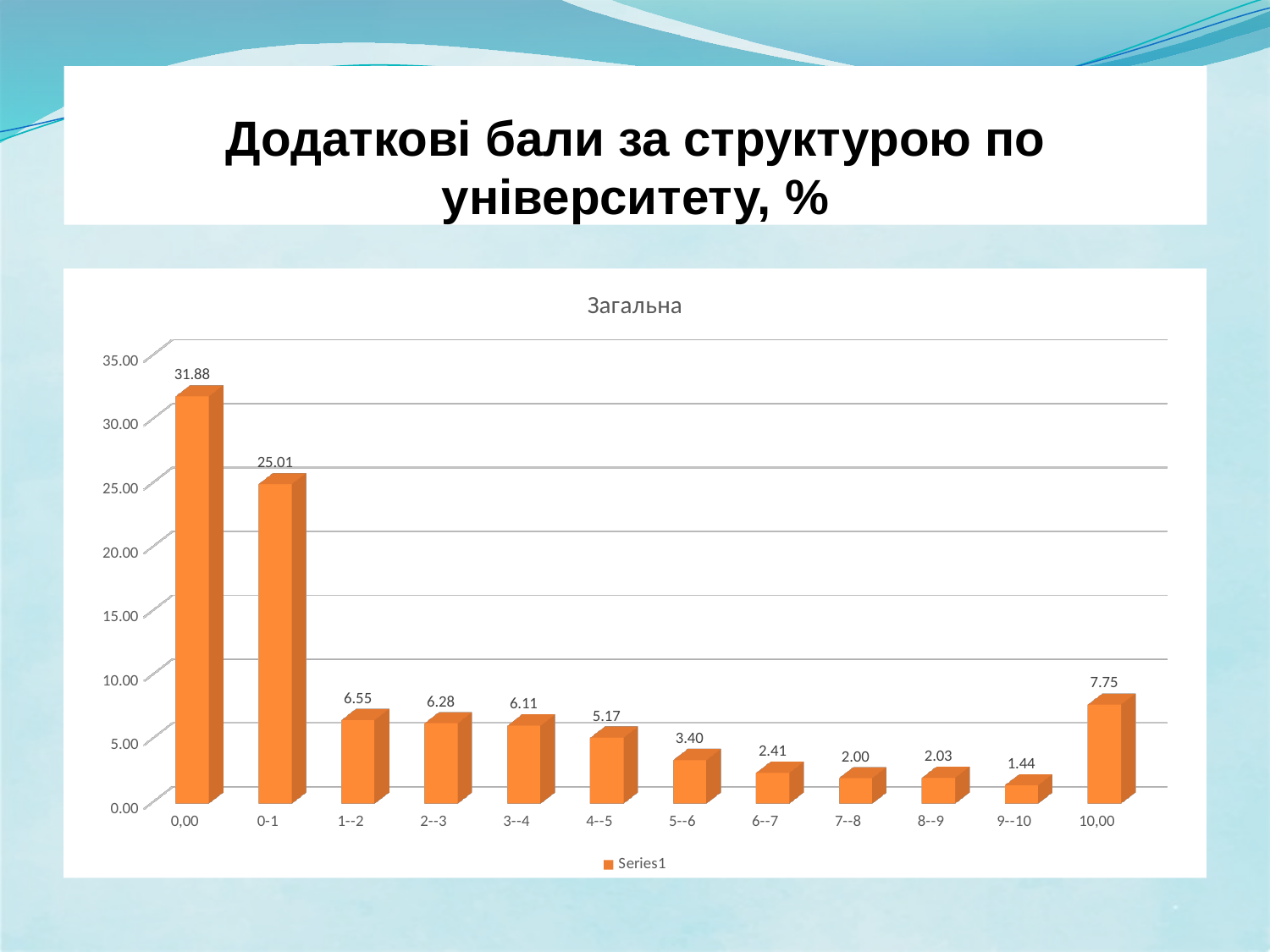
How many categories are shown on the x axis? 12 Which category has the highest value? 0,00 Which is larger, the value for 1--2 or the value for 10,00? 10,00 What is the value for the category 5--6? 3.40 What is the value for the category 10,00? 7.75 What is the difference between the values for 0,00 and 0-1? 6.87 What is the value for the category 0,00? 31.88 How many series does the legend list? 1 Is the value for 0-1 greater or less than 20.00? greater What is the title shown above the chart area? Загальна What kind of chart is shown on the slide? bar chart Which category has the lowest value? 9--10